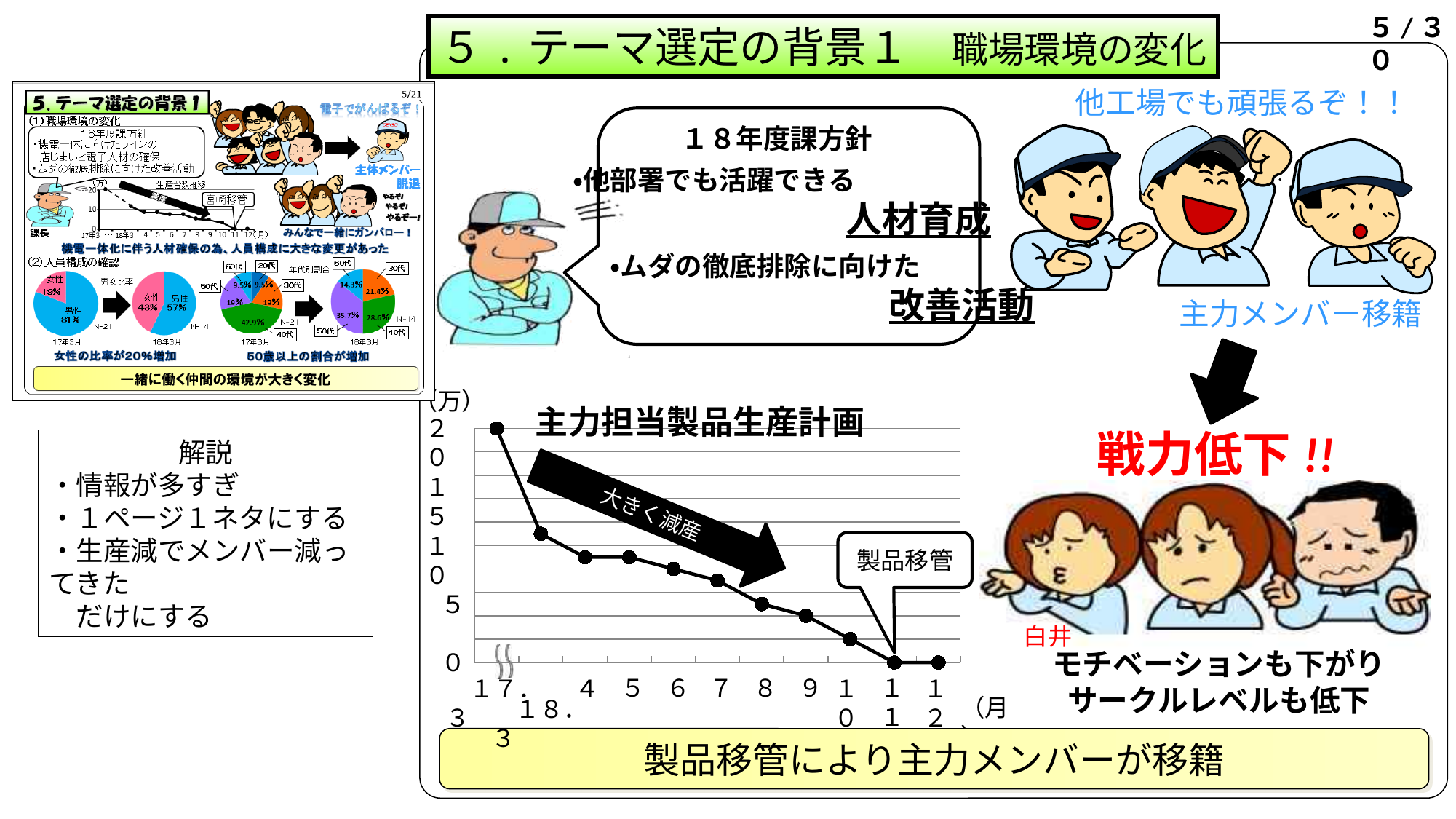
What is the difference between the value at 17.3 and the value at 11月 on the 主力担当製品生産計画 chart? 20 What kind of chart is the 主力担当製品生産計画 chart? line chart On the 主力担当製品生産計画 chart, is the value for 10月 greater or less than 5? less On the 主力担当製品生産計画 chart, which is larger, the value for 18.3 or the value for 9月? 18.3 Which x-axis point has the highest value on the 主力担当製品生産計画 chart? 17.3 On the 主力担当製品生産計画 chart, what is the value at 11月? 0 What unit is shown at the top of the y-axis of the 主力担当製品生産計画 chart? 万 On the 主力担当製品生産計画 chart, is the value for 18.3 greater or less than 15? less How many data points are plotted on the 主力担当製品生産計画 line chart? 11 Do the values on the 主力担当製品生産計画 chart rise or fall from 17.3 to 12月? fall On the 主力担当製品生産計画 chart, what is the value (in 万) at 17.3? 20 What is the title of the line chart on the slide? 主力担当製品生産計画